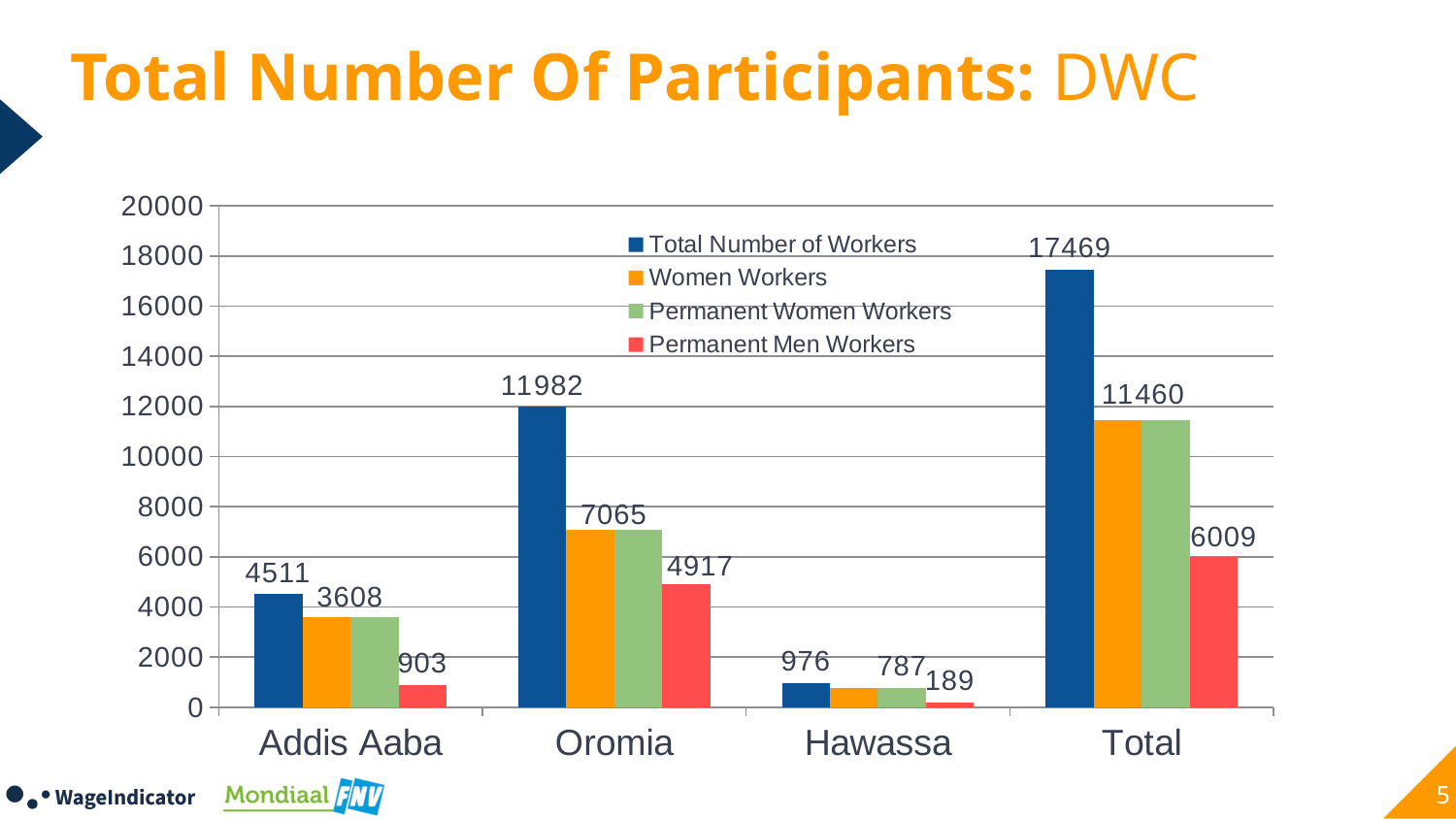
How many categories are shown on the x axis? 4 Excluding the Total category, which category has the highest Total Number of Workers? Oromia What is the Total Number of Workers for Oromia? 11982 What is the value for Permanent Men Workers in Hawassa? 189 What is the value for Women Workers in Addis Aaba? 3608 Is the value for Permanent Women Workers in Oromia greater or less than 6000? greater What kind of chart is shown on the slide? bar chart What is the value for Permanent Men Workers in the Total category? 6009 How many series does the legend list? 4 Which is larger: Permanent Men Workers in Oromia or in Addis Aaba? Oromia Which category has the lowest Total Number of Workers? Hawassa What is the difference between the Total Number of Workers and Women Workers in Oromia? 4917